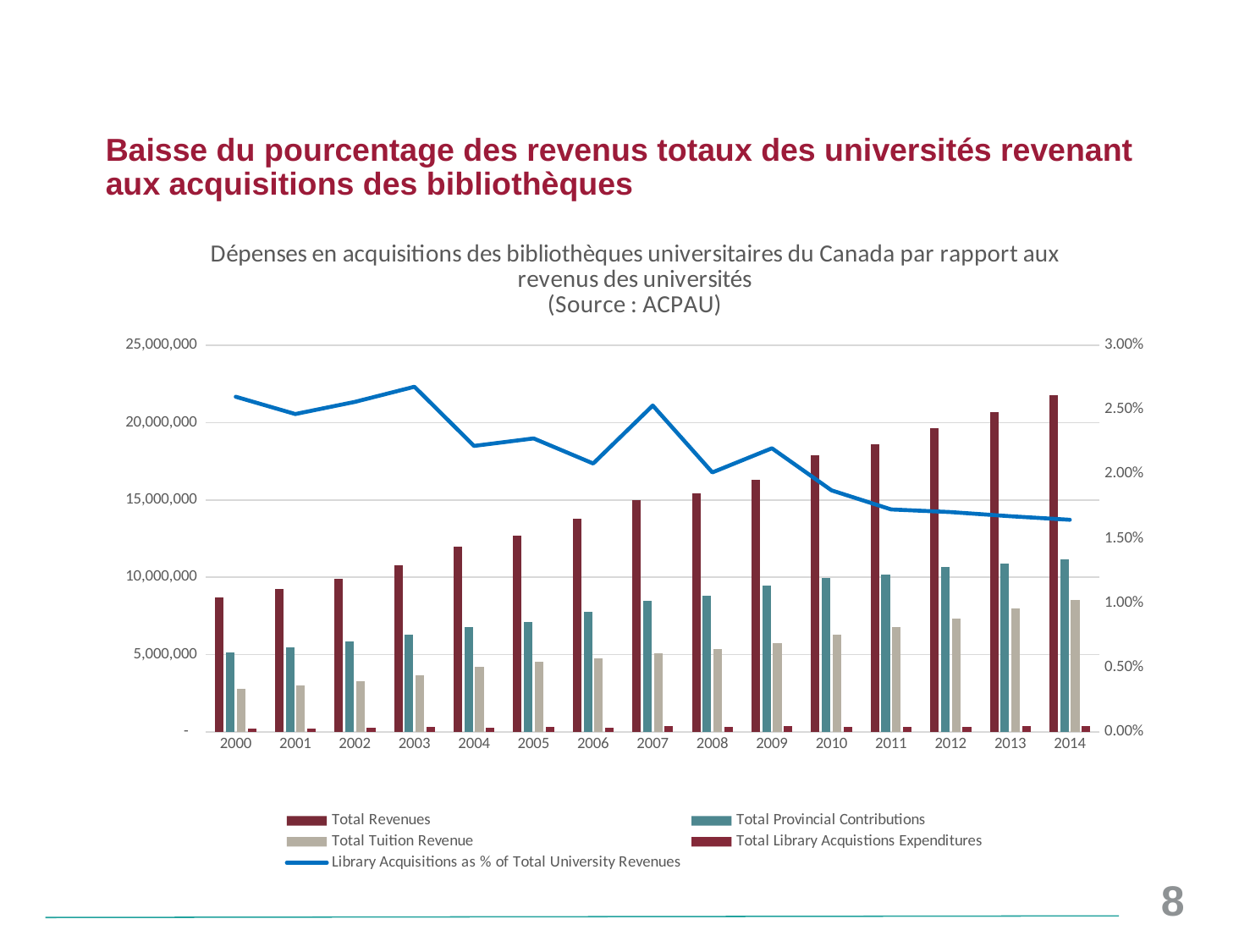
In which year is Total Revenues lowest? 2000 Is the value for Library Acquisitions as % of Total University Revenues in 2014 greater or less than 2.00%? less In which year is Total Revenues highest? 2014 Is the value for Total Revenues in 2014 greater or less than 20,000,000? greater How many years are shown on the x axis? 15 What kind of chart is shown on the slide? A combined bar and line chart What source is cited in the chart title? ACPAU Is the value for Total Revenues in 2000 greater or less than 10,000,000? less How many series does the legend list? 5 In 2014, which is larger: Total Provincial Contributions or Total Tuition Revenue? Total Provincial Contributions Does the line for Library Acquisitions as % of Total University Revenues rise or fall from 2000 to 2014? Fall Do the Total Revenues bars rise or fall from 2000 to 2014? Rise